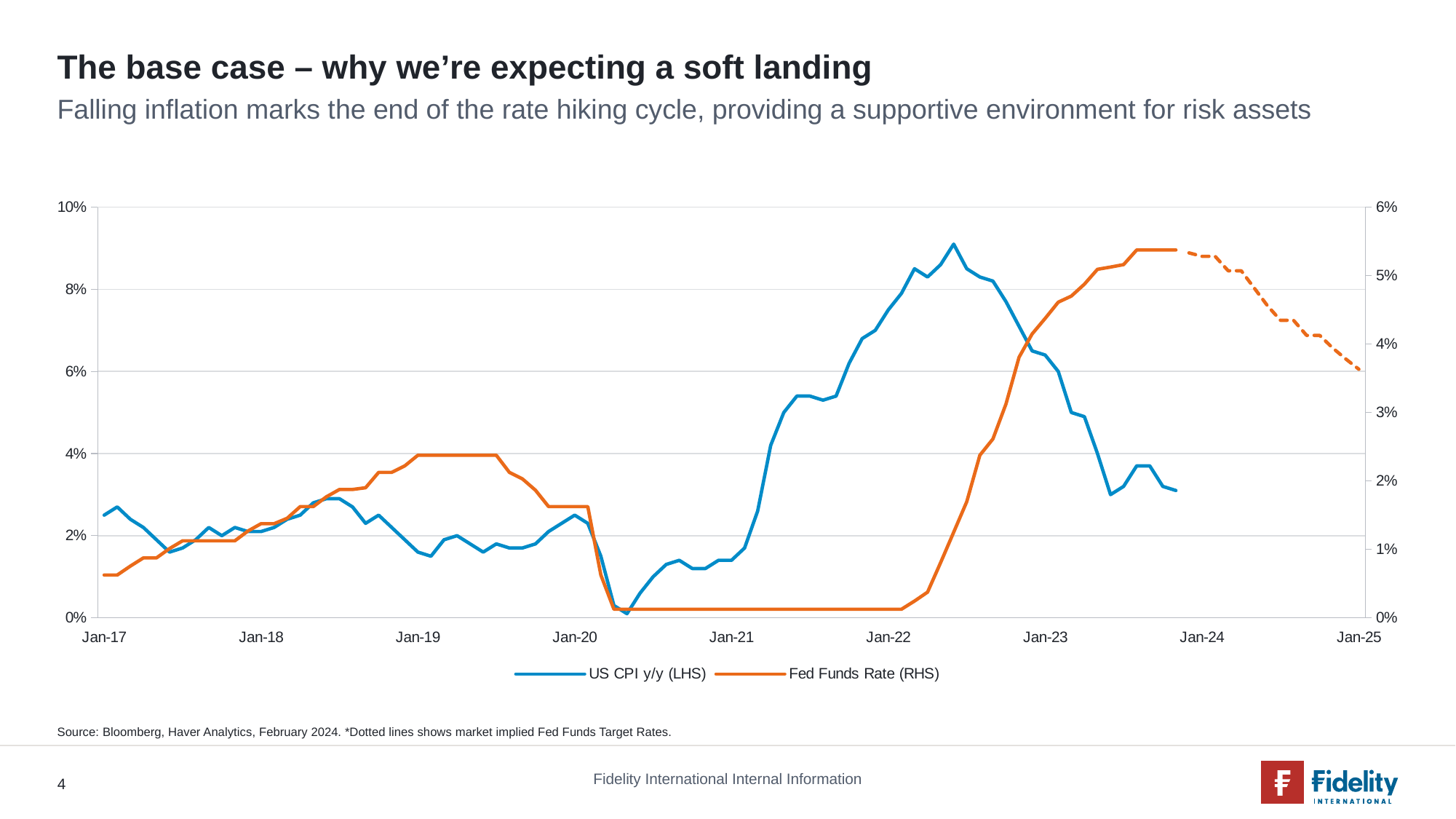
What are the two series named in the legend? US CPI y/y (LHS) and Fed Funds Rate (RHS) Is the market implied Fed Funds Rate at Jan-25 greater or less than 4%? less What kind of chart is shown on the slide? Line chart Does the Fed Funds Rate rise or fall between Jan-22 and Jan-24? rise Is the value of US CPI y/y at Jan-22 greater or less than 6%? greater How many year labels are shown on the x axis? 9 How many series does the legend list? 2 According to the source note, what do the dotted lines show? Market implied Fed Funds Target Rates Is the value of the Fed Funds Rate at Jan-24 greater or less than 5%? greater Does US CPI y/y rise or fall between Jan-23 and Jan-24? fall